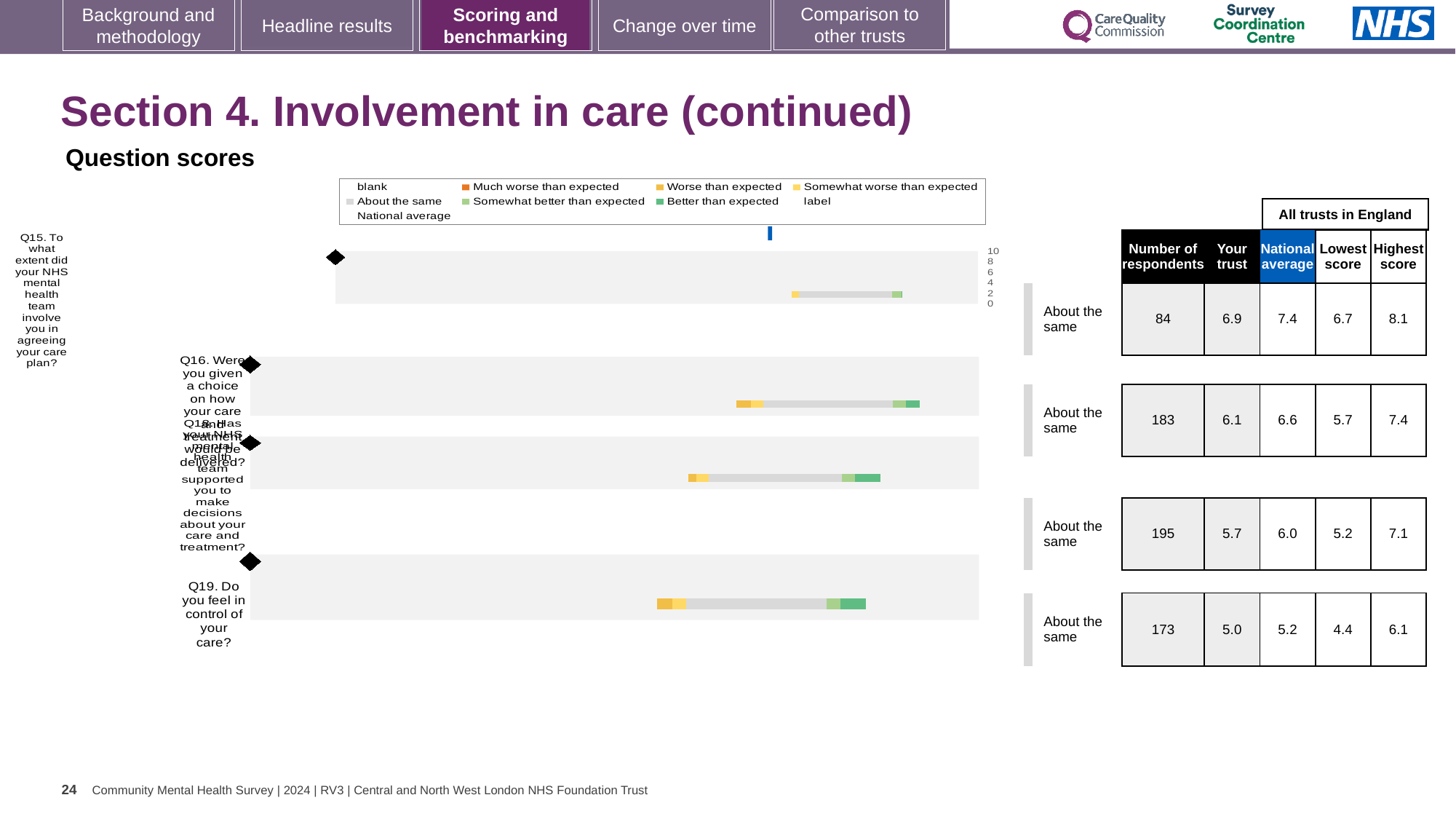
Which question has the lowest national average score? Q19 What is the difference between the national average and the 'Your trust' score for Q16? 0.5 What kind of chart is used to show the question scores? Bar chart What is the national average score for Q19 (Do you feel in control of your care?)? 5.2 Which is larger for Q18: the 'Your trust' score or the national average? National average Which question has the highest 'Your trust' score? Q15 What benchmark category is shown for Q15? About the same What is the highest score among all trusts in England for Q18? 7.1 How many respondents answered Q16 (Were you given a choice on how your care and treatment would be delivered?)? 183 How many questions are shown in the chart? 4 What is the lowest score among all trusts in England for Q19? 4.4 What is the 'Your trust' score for Q15 (To what extent did your NHS mental health team involve you in agreeing your care plan?)? 6.9